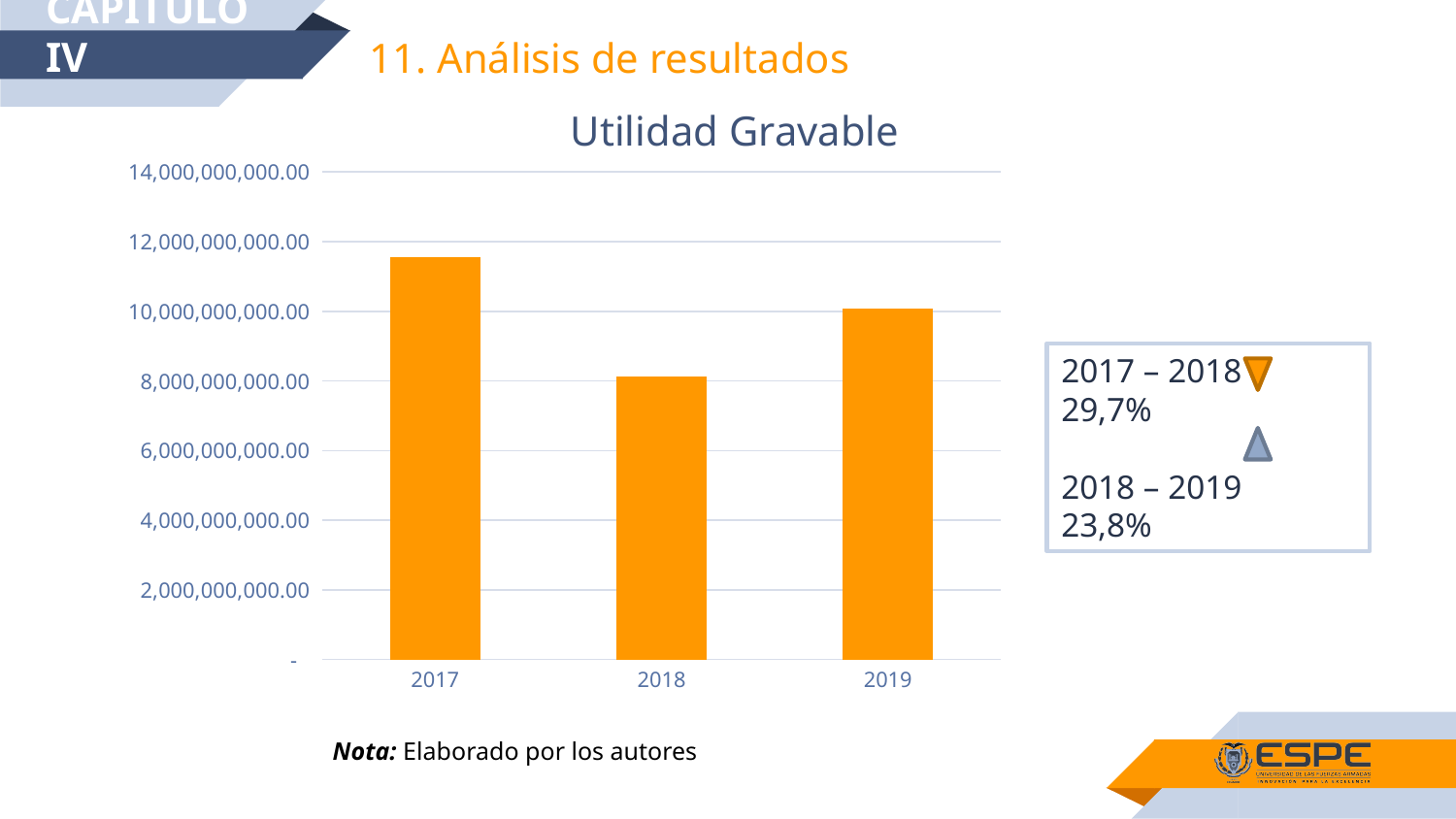
Is the value for 2019 greater or less than 12,000,000,000.00? less Which is larger, the value for 2017 or the value for 2019? 2017 Which year has the lowest Utilidad Gravable? 2018 What kind of chart is shown on the slide? bar chart How many years are shown on the x axis of the chart? 3 Which year has the highest Utilidad Gravable? 2017 Which is larger, the value for 2018 or the value for 2019? 2019 What is the title of the chart? Utilidad Gravable Is the value for 2018 greater or less than 10,000,000,000.00? less According to the text box next to the chart, what is the percentage change shown for 2018 – 2019? 23,8% Is the value for 2017 greater or less than 10,000,000,000.00? greater Does the value rise or fall from 2017 to 2018? fall